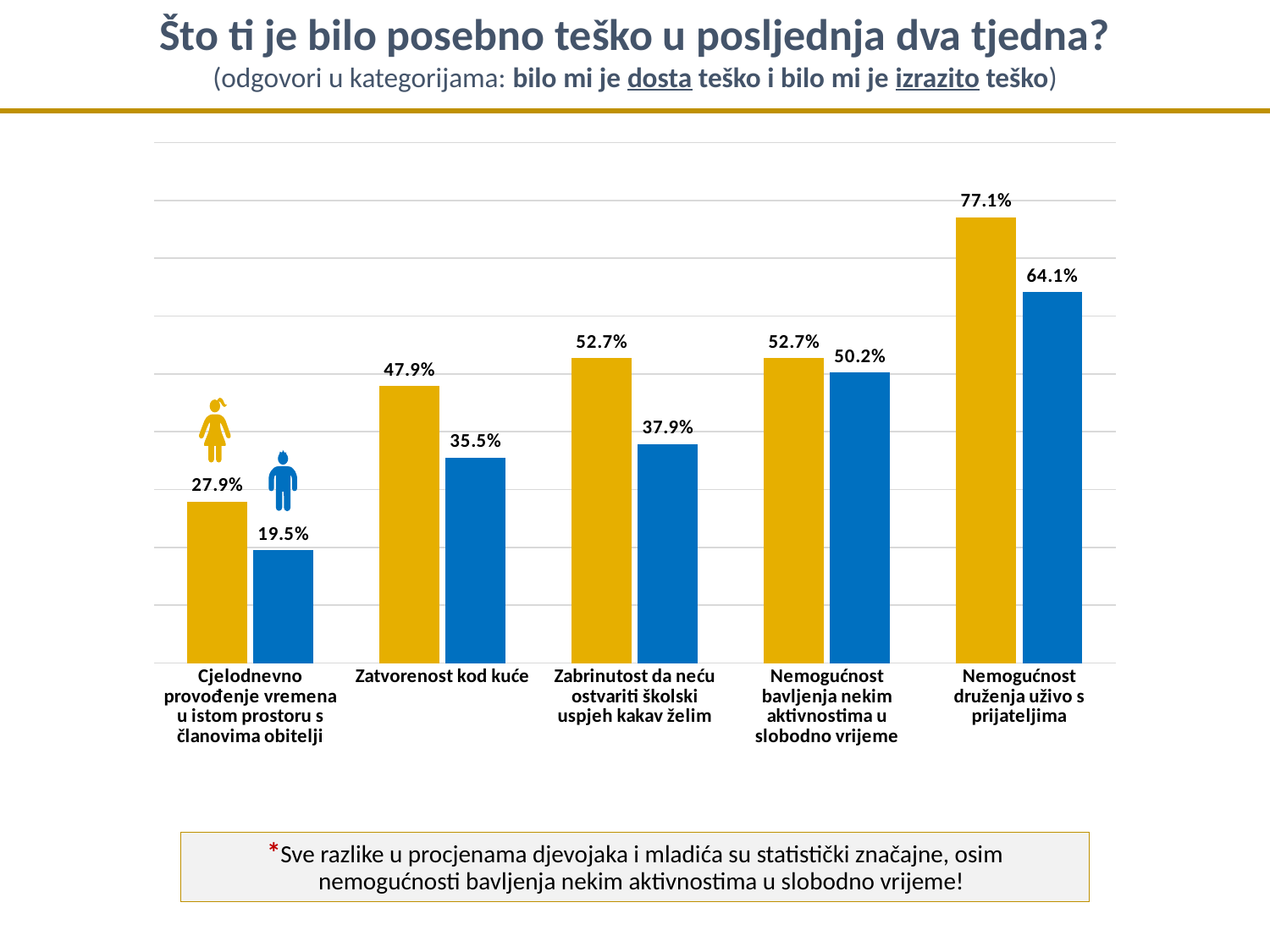
What is the value of the blue bar for "Cjelodnevno provođenje vremena u istom prostoru s članovima obitelji"? 19.5% What is the value of the yellow bar for "Zabrinutost da neću ostvariti školski uspjeh kakav želim"? 52.7% How many data series does the chart show? 2 Which category has the lowest yellow bar? Cjelodnevno provođenje vremena u istom prostoru s članovima obitelji What is the value of the yellow bar for "Nemogućnost druženja uživo s prijateljima"? 77.1% What kind of chart is shown on the slide? bar chart What is the value of the blue bar for "Zatvorenost kod kuće"? 35.5% What is the difference between the yellow and blue bars for "Nemogućnost druženja uživo s prijateljima"? 13.0% Which is larger for "Zatvorenost kod kuće": the yellow bar or the blue bar? the yellow bar What is the difference between the yellow and blue bars for "Nemogućnost bavljenja nekim aktivnostima u slobodno vrijeme"? 2.5% How many categories are shown on the x axis? 5 Which category has the highest blue bar? Nemogućnost druženja uživo s prijateljima